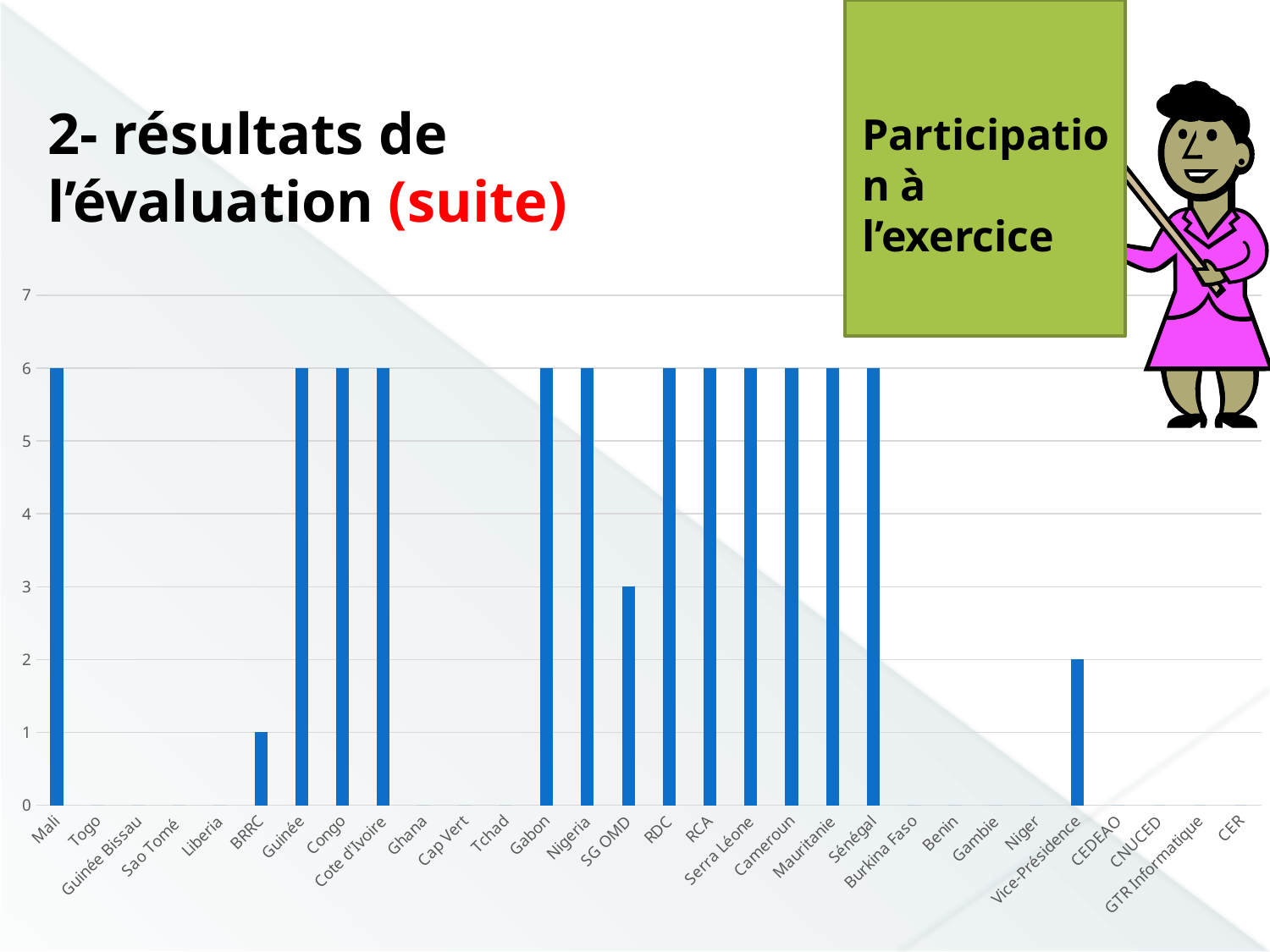
What is the value for Mali? 6 What kind of chart is shown on the slide? Bar chart What is the value for BRRC? 1 What is the difference between the value for Mali and the value for SG OMD? 3 Which is larger, the value for SG OMD or the value for Vice-Présidence? SG OMD What is the value for SG OMD? 3 What is the value for Vice-Présidence? 2 How many categories are shown on the x axis? 30 Is the value for Vice-Présidence greater or less than 3? less How many categories have a value of 6? 12 Is the value for Cameroun greater or less than 5? greater What is the title shown in the green box above the chart? Participation à l'exercice